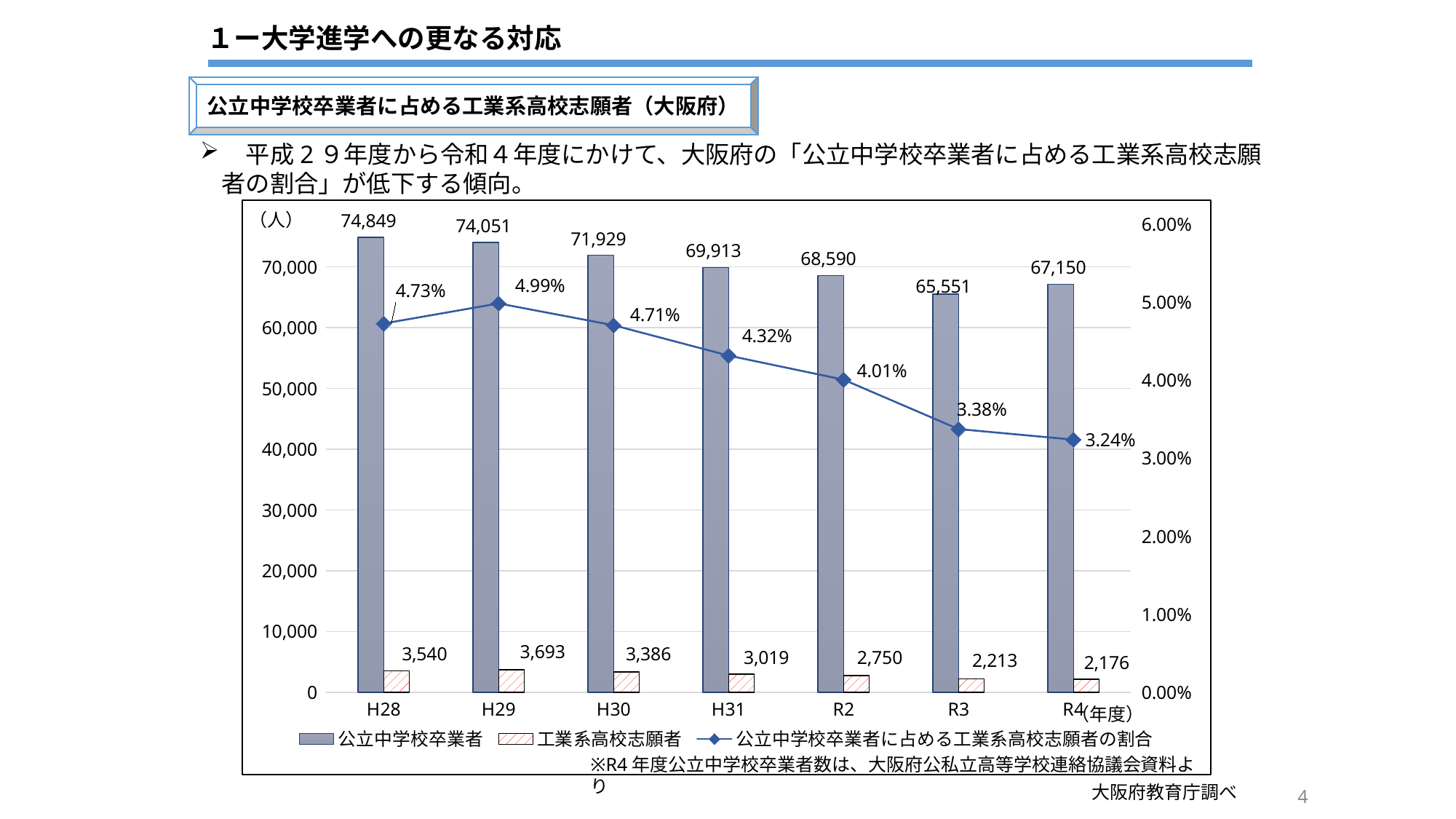
Does the 公立中学校卒業者に占める工業系高校志願者の割合 rise or fall from H29 to R4? fall What is the value of 公立中学校卒業者 for H28? 74,849 Is the 公立中学校卒業者 value for R3 greater or less than 60,000? greater In which year is the 工業系高校志願者 value lowest? R4 In which year is the 公立中学校卒業者に占める工業系高校志願者の割合 highest? H29 Which is larger, the 工業系高校志願者 value for H29 or for H30? H29 What is the title of the chart? 公立中学校卒業者に占める工業系高校志願者（大阪府） What is the 公立中学校卒業者に占める工業系高校志願者の割合 for H29? 4.99% How many years are shown on the x axis? 7 What is the difference between the 公立中学校卒業者 values for H28 and R4? 7,699 What is the value of 工業系高校志願者 for R2? 2,750 How many series does the legend list? 3